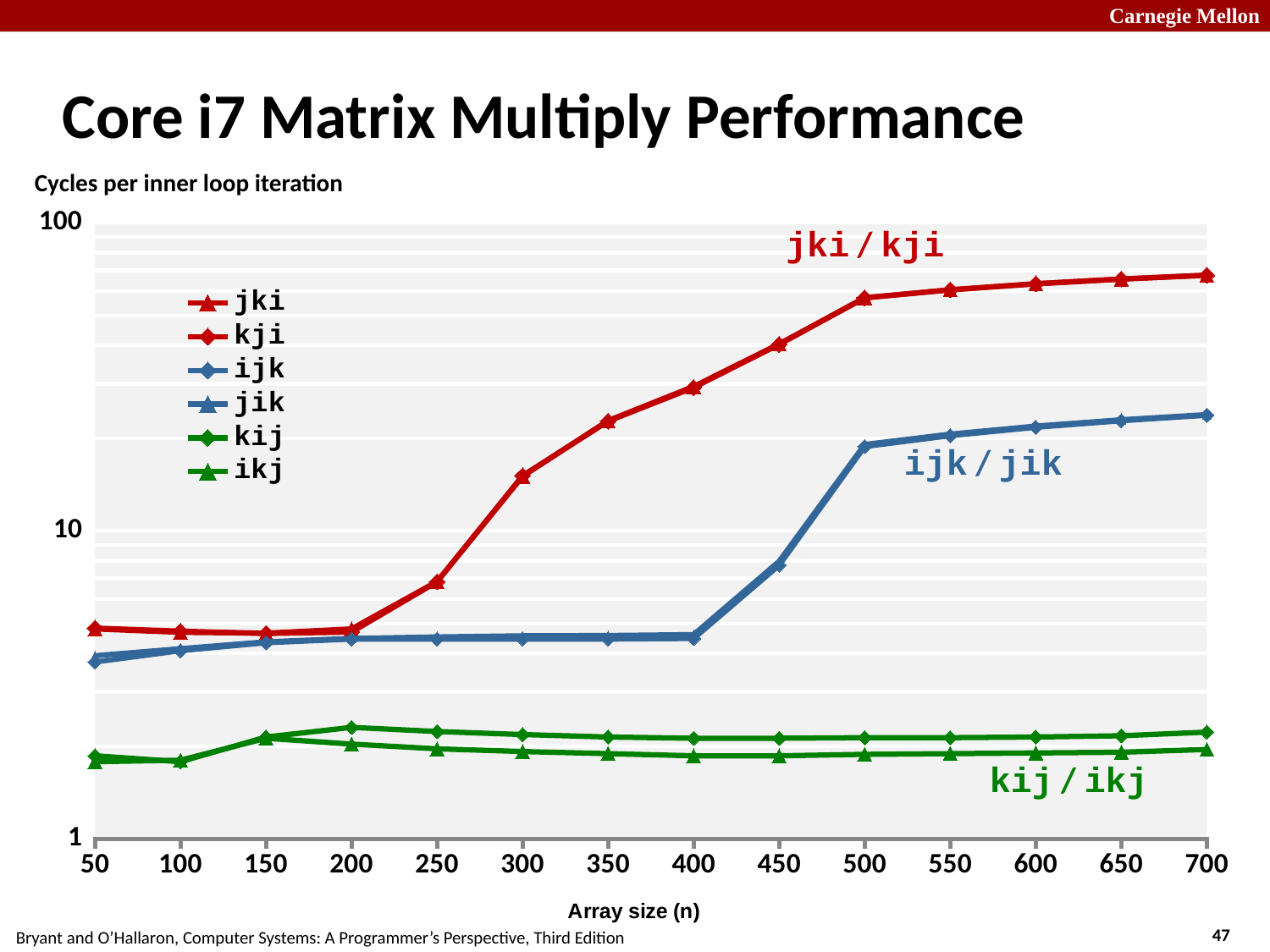
How many array-size values are marked along the x axis? 14 Do the values for jki rise or fall as the array size increases from 50 to 700? rise Is the value for kij at array size 700 greater or less than 10? less Is the value for jki at array size 50 greater or less than 10? less What kind of chart is shown on the slide? line chart Is the value for ijk at array size 400 greater or less than 10? less At array size 700, which is larger, the value for jki or the value for kij? jki How many series does the legend list? 6 What is the label of the x axis? Array size (n) What quantity does the y axis measure, according to the label above the chart? Cycles per inner loop iteration